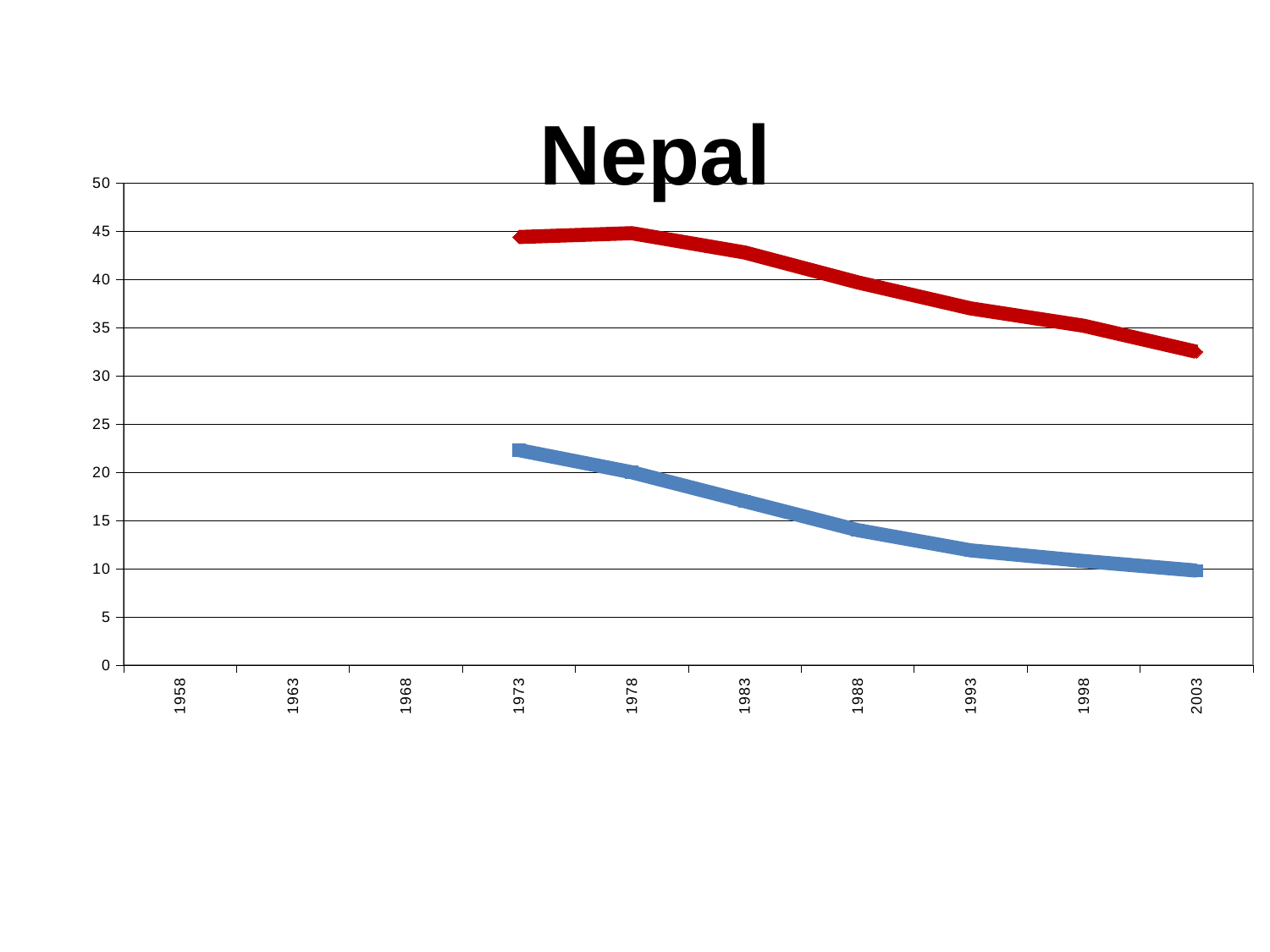
How many year labels are shown on the x axis? 10 What colours are the two lines on the chart? red and blue Is the value of the blue line in 2003 greater or less than 15? less What kind of chart is shown on the slide? line chart How many lines are plotted on the chart? 2 Is the value of the red line in 1973 greater or less than 40? greater In 2003, which line has the higher value, the red line or the blue line? the red line Is the value of the red line in 2003 greater or less than 35? less What is the title of the chart? Nepal Does the red line rise or fall between 1978 and 2003? fall Does the blue line rise or fall from 1973 to 2003? fall